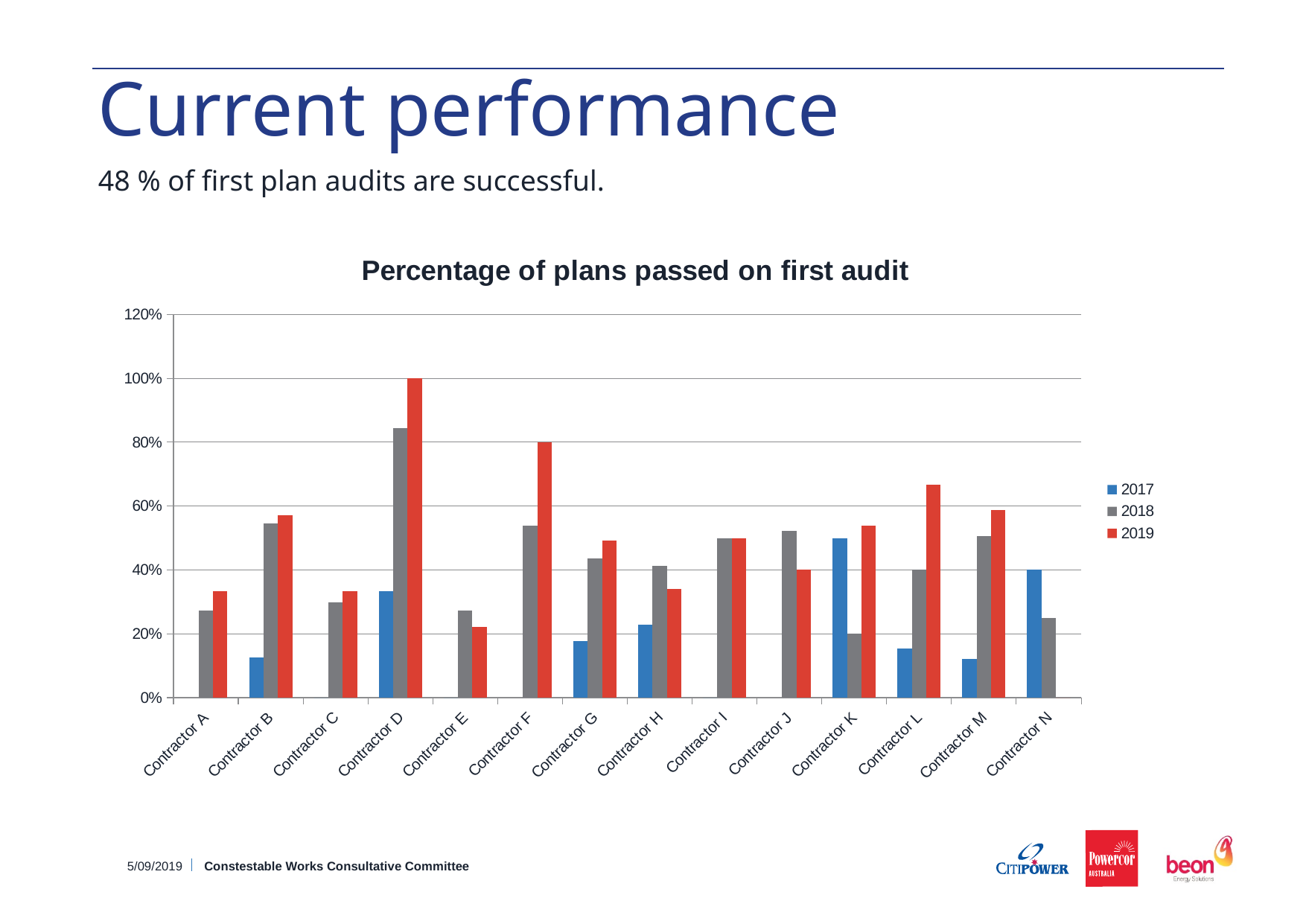
How many series does the legend list? 3 For Contractor L, which is larger: the 2018 value or the 2019 value? 2019 What is the 2017 value for Contractor N? 40% What is the 2019 value for Contractor F? 80% Is the 2017 value for Contractor B greater or less than 20%? less Which contractor has the highest 2019 value? Contractor D How many contractors are shown on the x axis? 14 What is the 2019 value for Contractor D? 100% Is the 2019 value for Contractor M greater or less than 40%? greater What kind of chart is shown on the slide? Bar chart What is the title of the chart? Percentage of plans passed on first audit